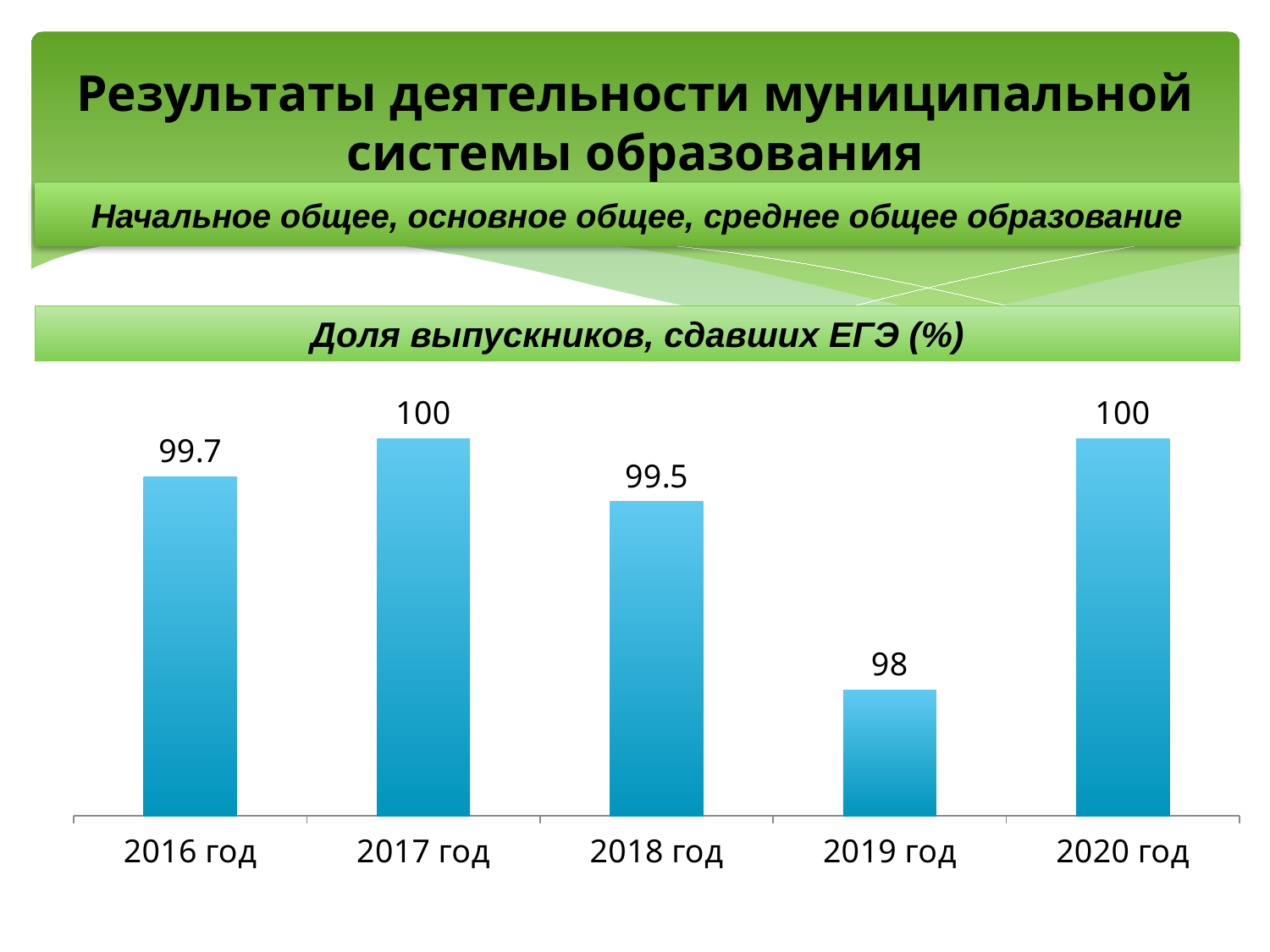
What is the difference between the values for 2017 год and 2019 год? 2 Does the value rise or fall from 2019 год to 2020 год? rise What is the value for 2018 год? 99.5 What is the difference between the values for 2016 год and 2018 год? 0.2 What is the value for 2016 год? 99.7 What is the title of the chart? Доля выпускников, сдавших ЕГЭ (%) What kind of chart is shown on the slide? bar chart What is the value for 2019 год? 98 What is the value for 2020 год? 100 How many years are shown on the chart? 5 Which year has the lowest value? 2019 год Which is larger, the value for 2016 год or the value for 2019 год? 2016 год